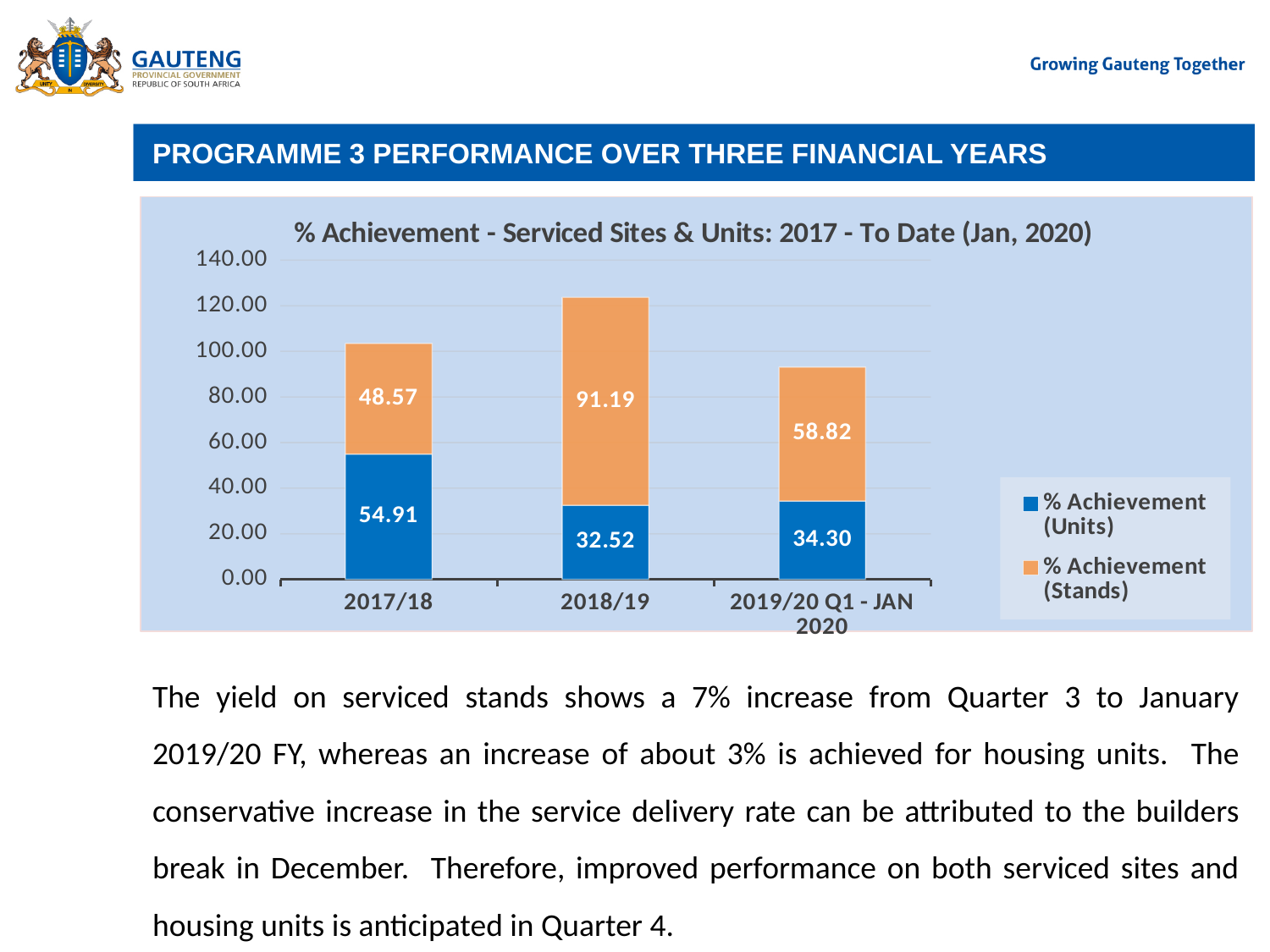
Which is larger for 2017/18: % Achievement (Units) or % Achievement (Stands)? % Achievement (Units) What is the difference between the % Achievement (Stands) values for 2018/19 and 2019/20 Q1 - JAN 2020? 32.37 What type of chart is shown on the slide? Stacked bar chart What is the % Achievement (Stands) value for 2018/19? 91.19 What is the % Achievement (Units) value for 2017/18? 54.91 Which financial year has the highest % Achievement (Stands) value? 2018/19 How many series does the legend list? 2 What is the total of the stacked bar for 2018/19? 123.71 What is the % Achievement (Units) value for 2019/20 Q1 - JAN 2020? 34.30 What is the total of the stacked bar for 2017/18? 103.48 How many financial year categories are shown on the x axis? 3 Which financial year has the lowest % Achievement (Units) value? 2018/19